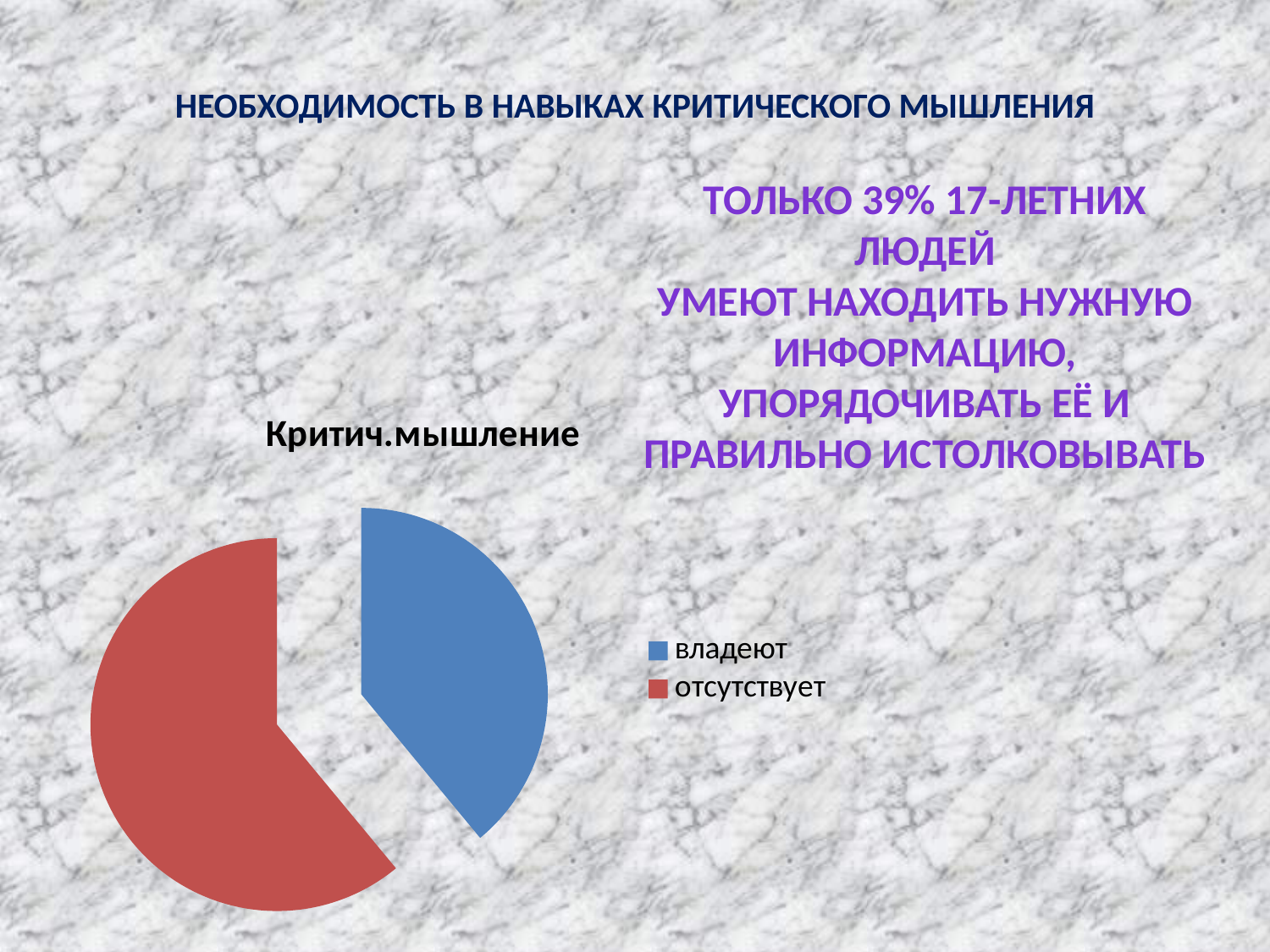
What kind of chart is shown on the slide? pie chart How many entries does the legend of the pie chart list? 2 Which slice of the pie chart is the smallest? владеют Which slice of the pie chart is the largest? отсутствует Which slice is larger in the pie chart, владеют or отсутствует? отсутствует What colour is the владеют slice in the pie chart? blue How many slices does the pie chart have? 2 What is the title of the pie chart? Критич.мышление